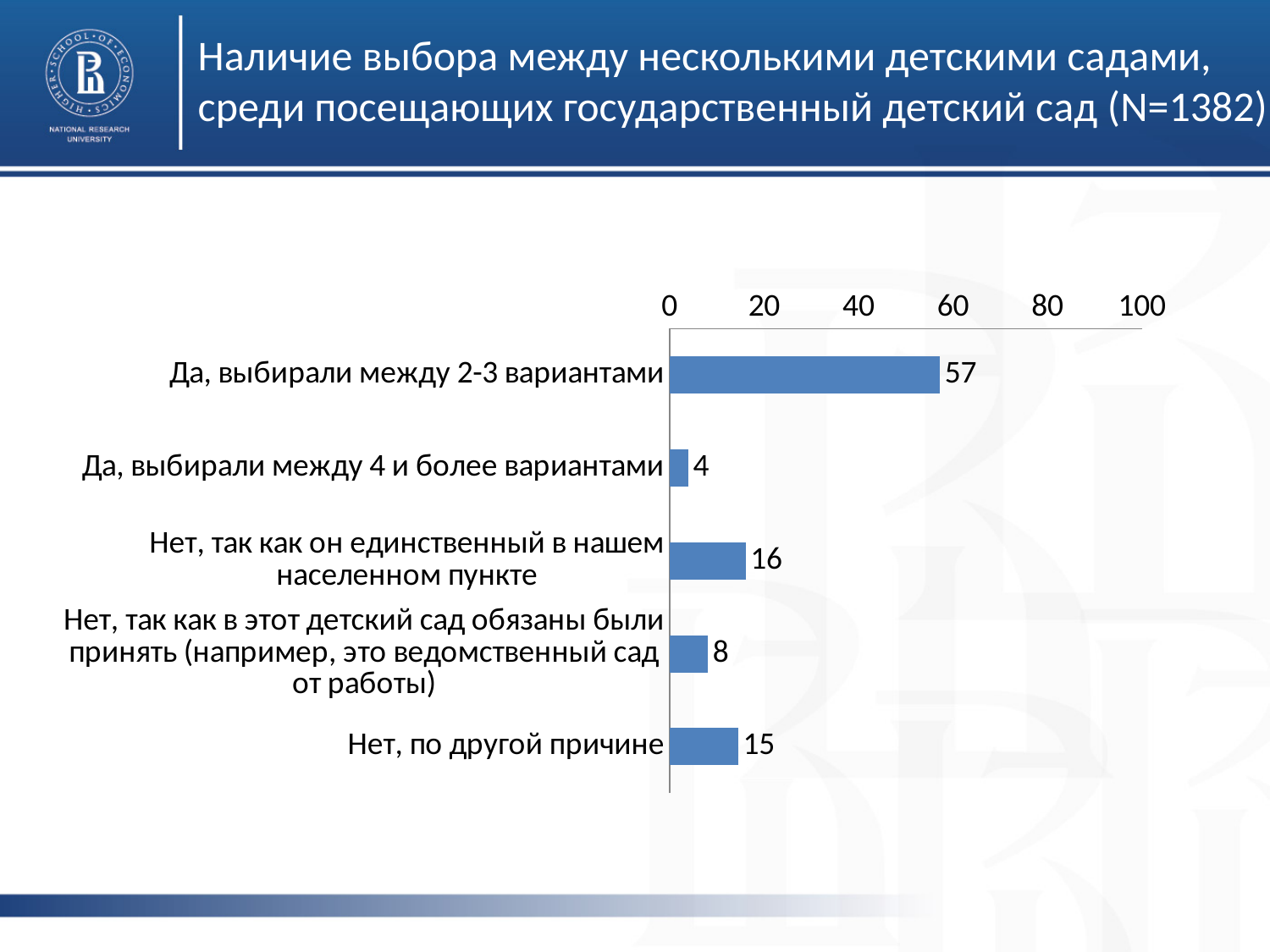
What is the value for "Нет, по другой причине"? 15 What is the value for "Да, выбирали между 2-3 вариантами"? 57 What is the maximum value shown on the chart's axis? 100 What kind of chart is shown on the slide? bar chart Which category has the highest value? Да, выбирали между 2-3 вариантами How many categories are shown in the chart? 5 What is the value for "Да, выбирали между 4 и более вариантами"? 4 Which is larger: the value for "Нет, по другой причине" or the value for "Нет, так как в этот детский сад обязаны были принять (например, это ведомственный сад от работы)"? Нет, по другой причине Which category has the lowest value? Да, выбирали между 4 и более вариантами What is the value for "Нет, так как он единственный в нашем населенном пункте"? 16 What is the difference between the values for "Да, выбирали между 2-3 вариантами" and "Нет, так как он единственный в нашем населенном пункте"? 41 Is the value for "Да, выбирали между 2-3 вариантами" greater or less than 40? greater